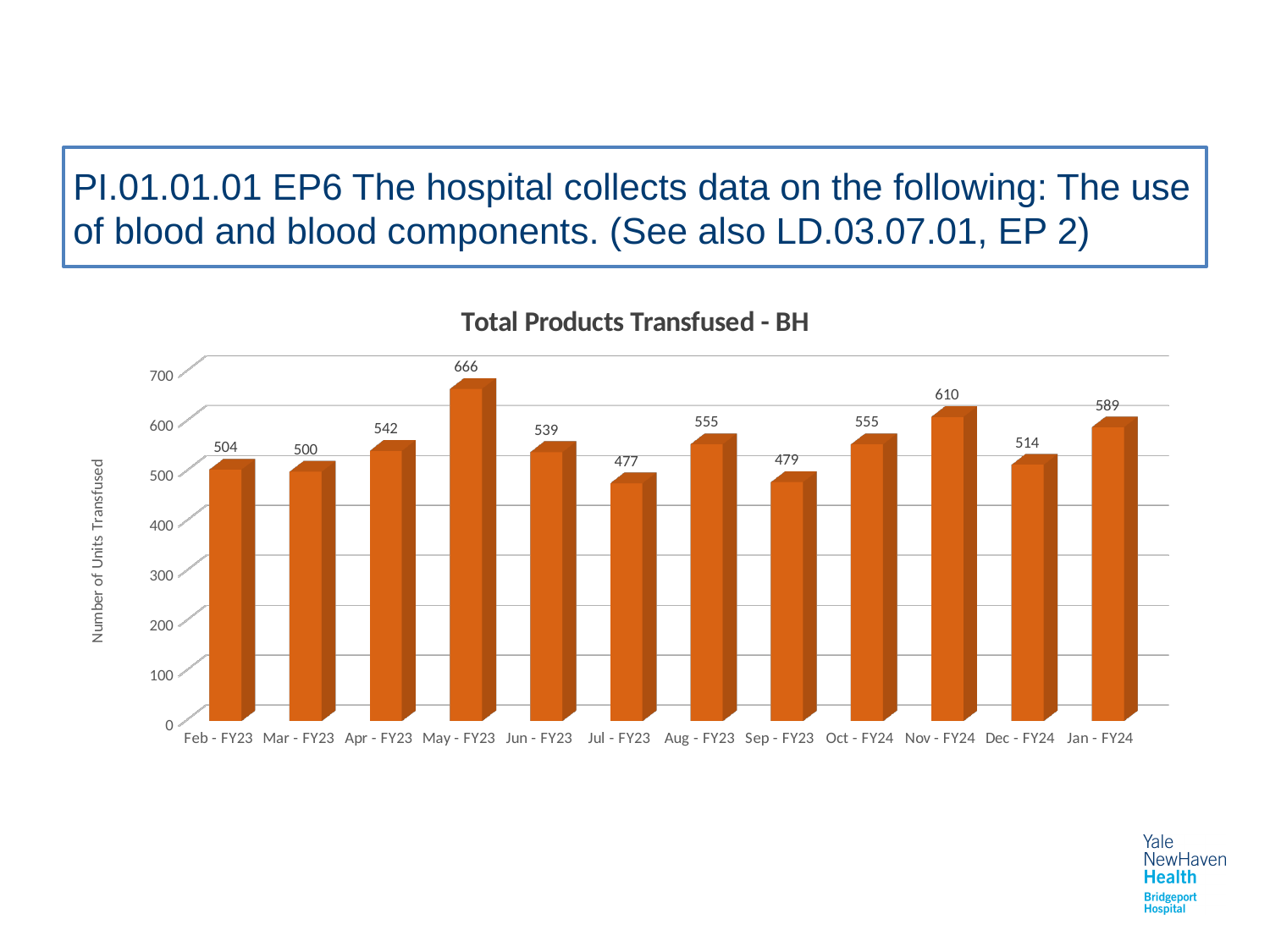
Which month has the highest number of units transfused? May - FY23 What is the title of the chart? Total Products Transfused - BH Which is larger, the value for Apr - FY23 or the value for Jun - FY23? Apr - FY23 What is the difference between the values for May - FY23 and Jul - FY23? 189 What is the value for Nov - FY24? 610 How many months are shown on the x axis? 12 Is the value for Jan - FY24 greater or less than 500? greater What is the value for Jul - FY23? 477 What kind of chart is shown on the slide? bar chart What is the value for May - FY23? 666 What is the difference between the values for Nov - FY24 and Dec - FY24? 96 Which month has the lowest number of units transfused? Jul - FY23